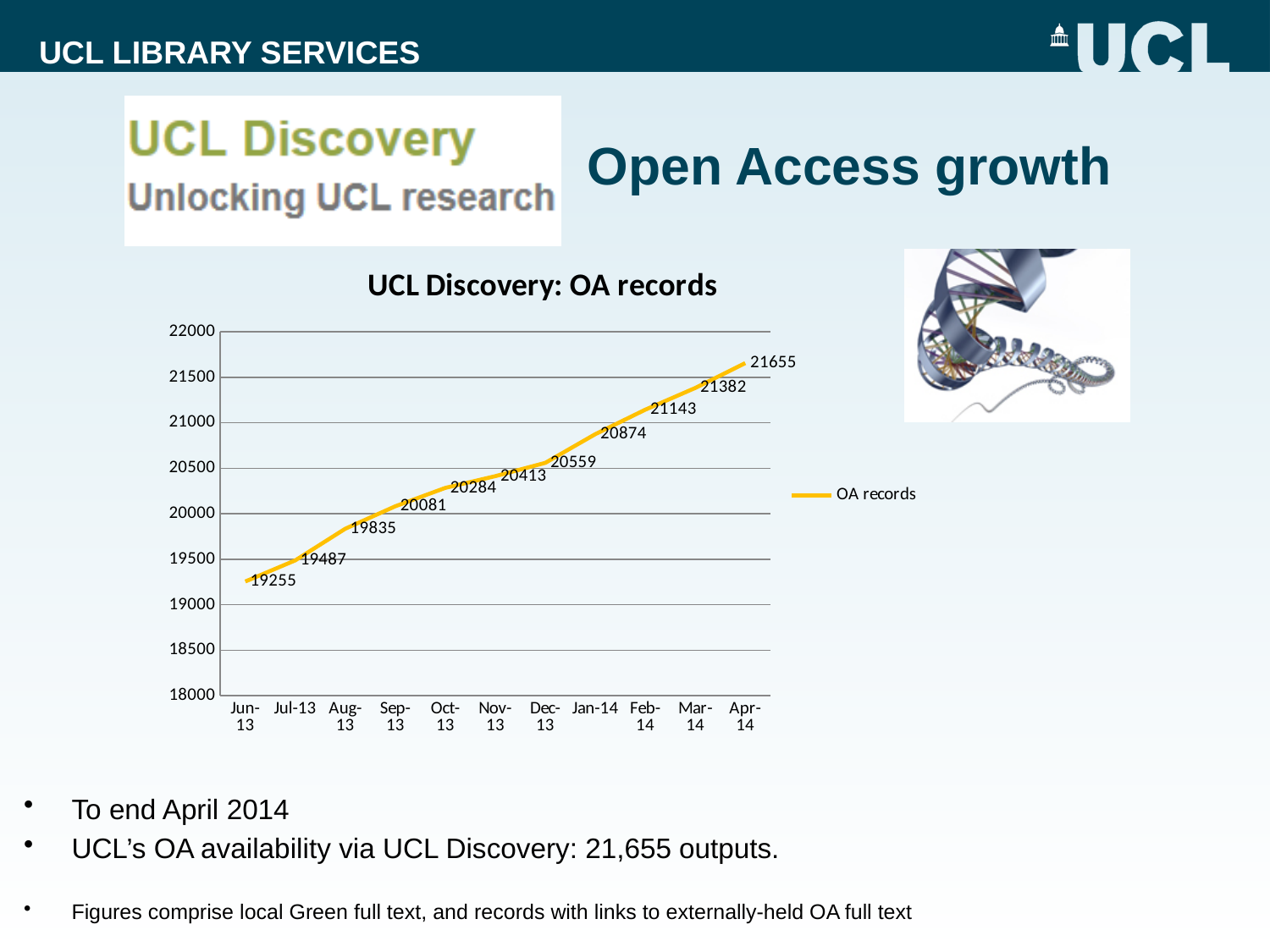
What is the value of OA records for Apr-14? 21655 What is the difference in OA records between Mar-14 and Feb-14? 239 How many data points are plotted on the line? 11 What is the value of OA records for Jun-13? 19255 What type of chart is shown on the slide? line chart Do the OA records values rise or fall from Jun-13 to Apr-14? rise Which month has the highest number of OA records? Apr-14 What is the difference in OA records between Apr-14 and Jun-13? 2400 What is the title of the chart? UCL Discovery: OA records What is the value of OA records for Dec-13? 20559 Which is larger, the OA records value for Sep-13 or for Nov-13? Nov-13 Which month has the lowest number of OA records? Jun-13